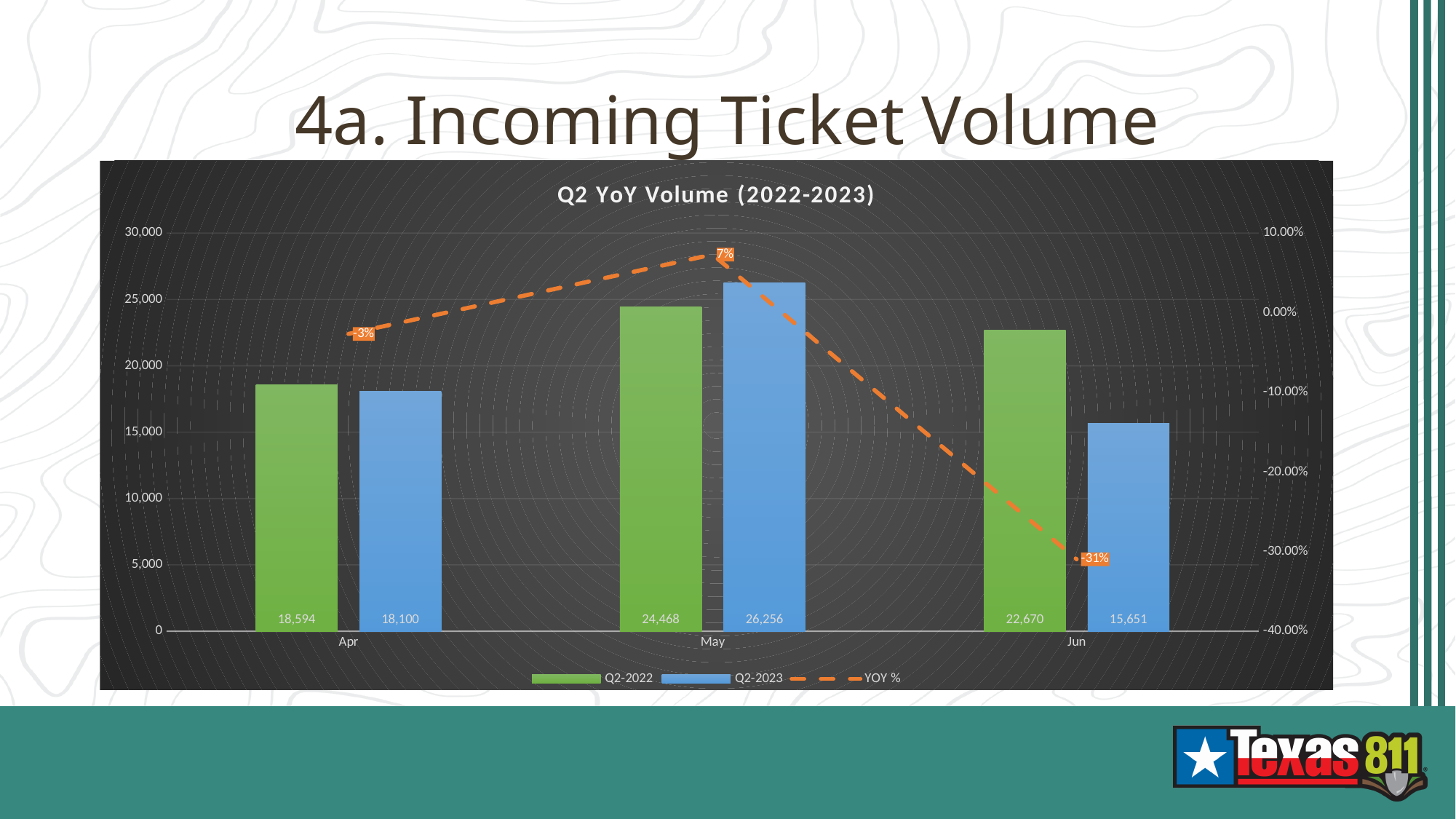
What is the title of the chart? Q2 YoY Volume (2022-2023) What is the Q2-2023 value for Jun? 15,651 What is the YOY % value for Jun? -31% What is the Q2-2022 value for Apr? 18,594 Which month has the lowest Q2-2022 value? Apr What is the difference between the Q2-2022 and Q2-2023 values for Jun? 7,019 For May, which is larger: the Q2-2022 value or the Q2-2023 value? Q2-2023 How many series does the legend list? 3 Which month has the highest Q2-2023 value? May What is the Q2-2023 value for May? 26,256 What kind of chart is used for the Q2-2022 and Q2-2023 series? Bar chart How many months are shown on the x axis? 3